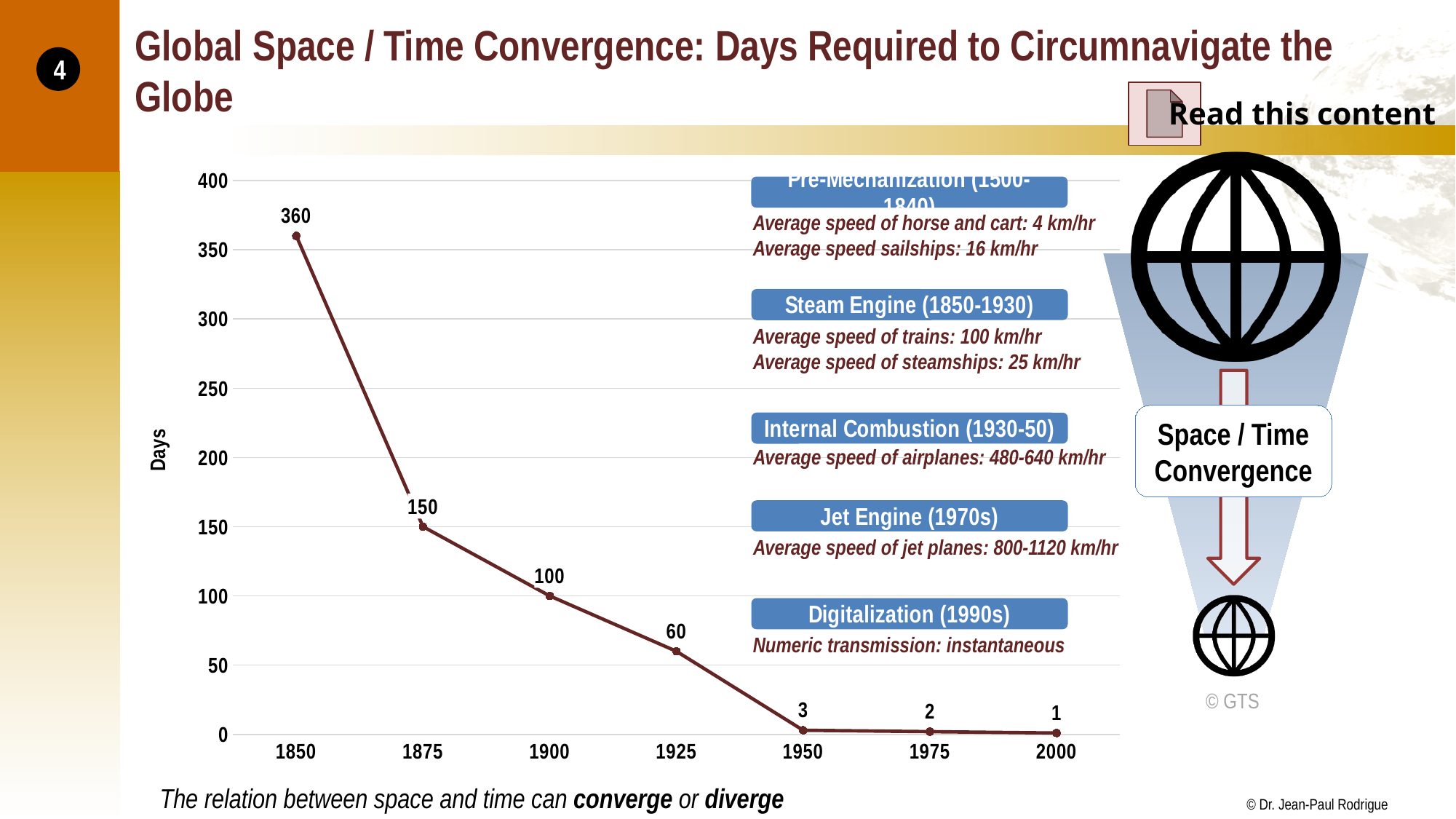
What is the value for 1900 on the chart? 100 Which year has the lowest number of days? 2000 What is the value plotted for 2000? 1 What kind of chart is shown on the slide? line chart What is the difference between the values for 1900 and 1925? 40 Which is larger, the value for 1950 or the value for 1975? 1950 What is the difference in days between 1850 and 1875? 210 How many days are shown for 1925? 60 Do the values rise or fall from 1850 to 2000? fall How many days were required to circumnavigate the globe in 1850? 360 How many data points are plotted on the line? 7 Which year has the highest number of days? 1850